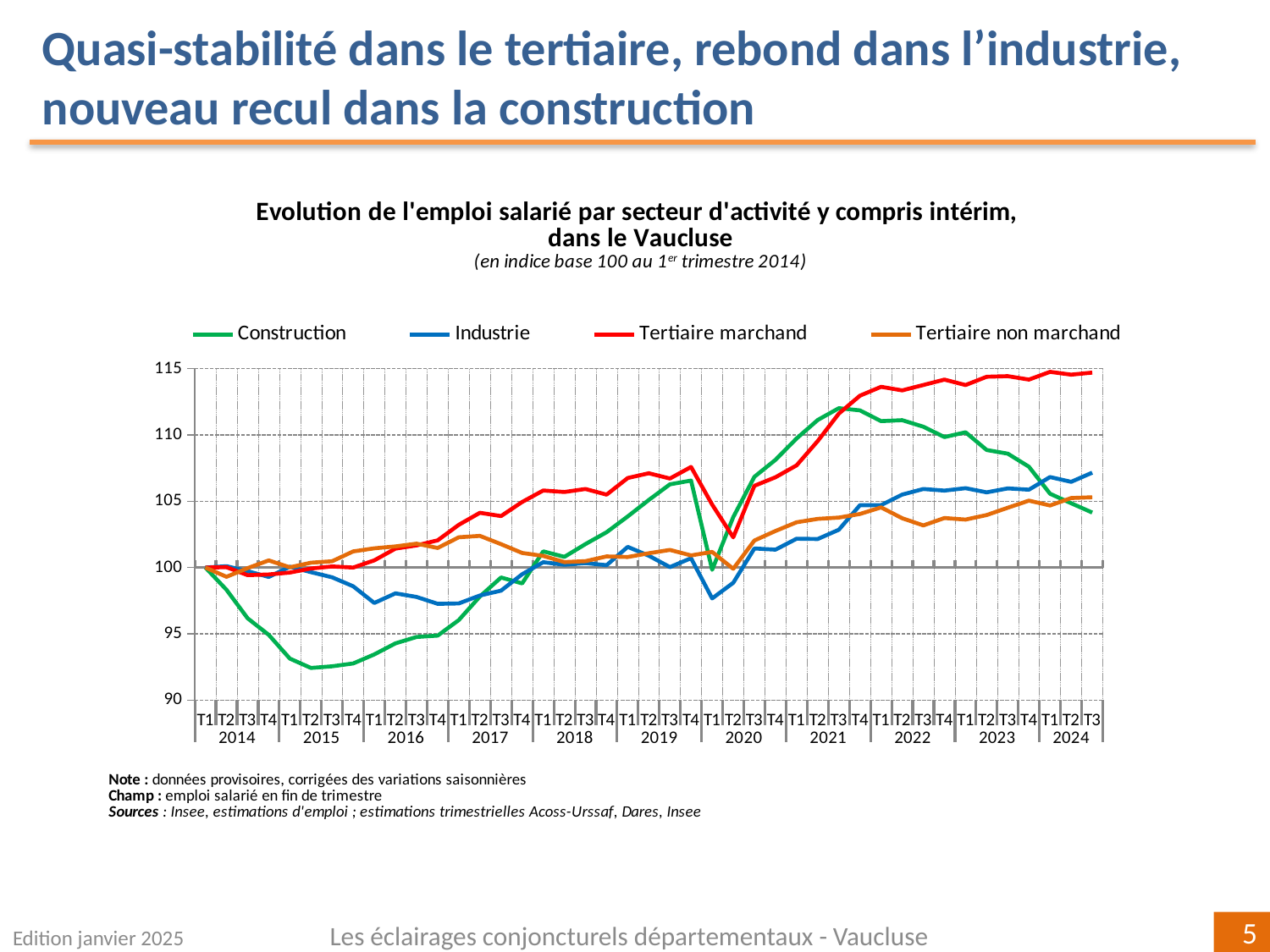
Is the value for Construction at T3 2021 greater or less than 110? greater Which series has the highest value at T3 2024? Tertiaire marchand Is the value for Industrie at T1 2020 greater or less than 100? less How many series does the legend list? 4 Which series has the lowest value at T2 2015? Construction What is the index value of all four series at T1 2014? 100 Is the value for Tertiaire marchand at T3 2024 greater or less than 110? greater Does the Construction line rise or fall between T3 2021 and T3 2024? fall At T3 2021, which is larger: Construction or Industrie? Construction What kind of chart is shown on the slide? line chart Which series is represented by the red line? Tertiaire marchand